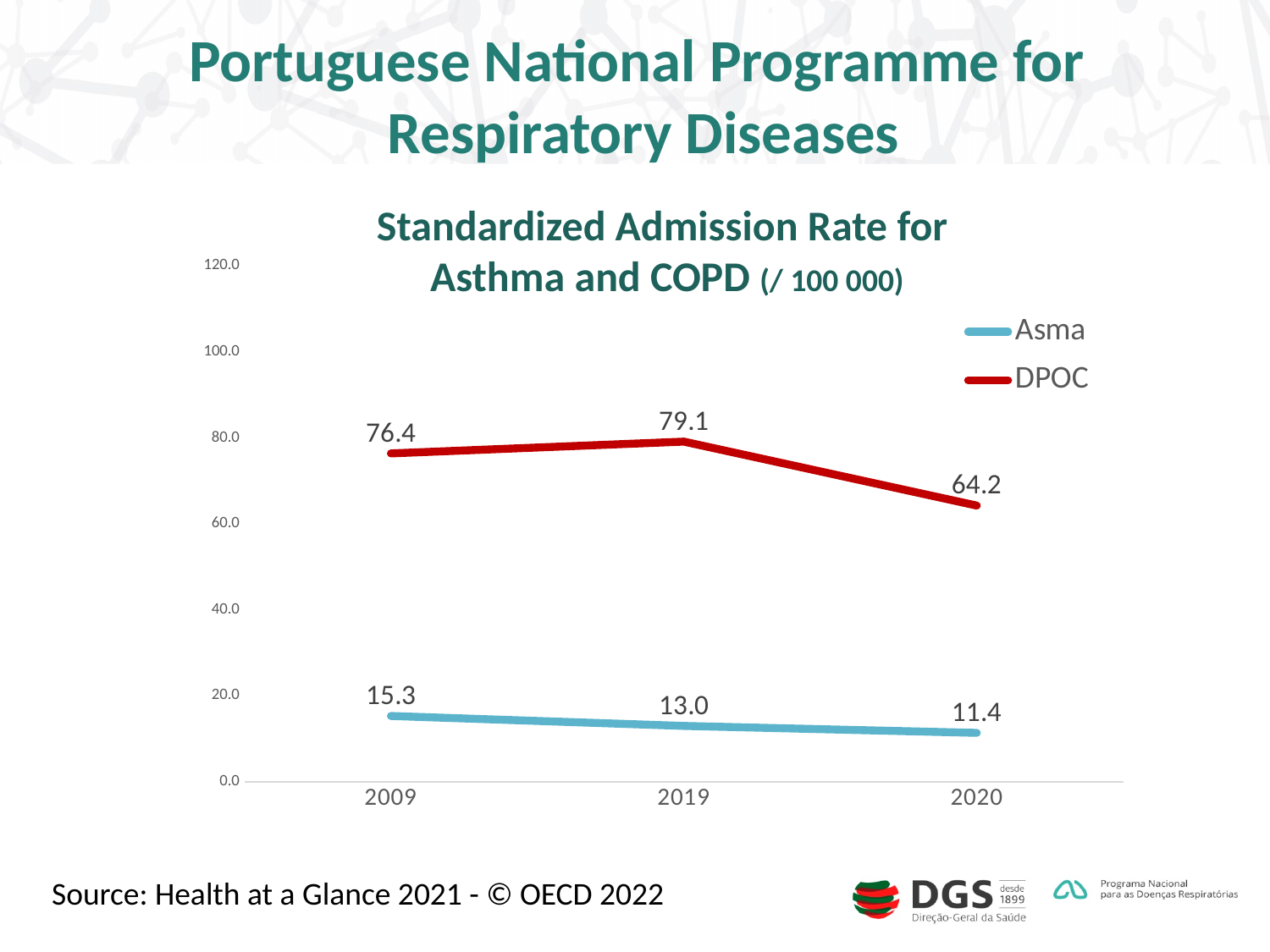
What is the DPOC value for 2019? 79.1 In which year is the DPOC value highest? 2019 How many series does the legend list? 2 Which is larger, the DPOC value for 2009 or the DPOC value for 2020? 2009 What is the difference between the DPOC values for 2019 and 2020? 14.9 Is the DPOC value for 2020 greater or less than 60.0? greater Does the Asma series rise or fall from 2009 to 2020? fall What is the DPOC value for 2009? 76.4 What is the Asma value for 2020? 11.4 In which year is the Asma value lowest? 2020 What kind of chart is shown on the slide? line chart What is the difference between the Asma values for 2009 and 2020? 3.9